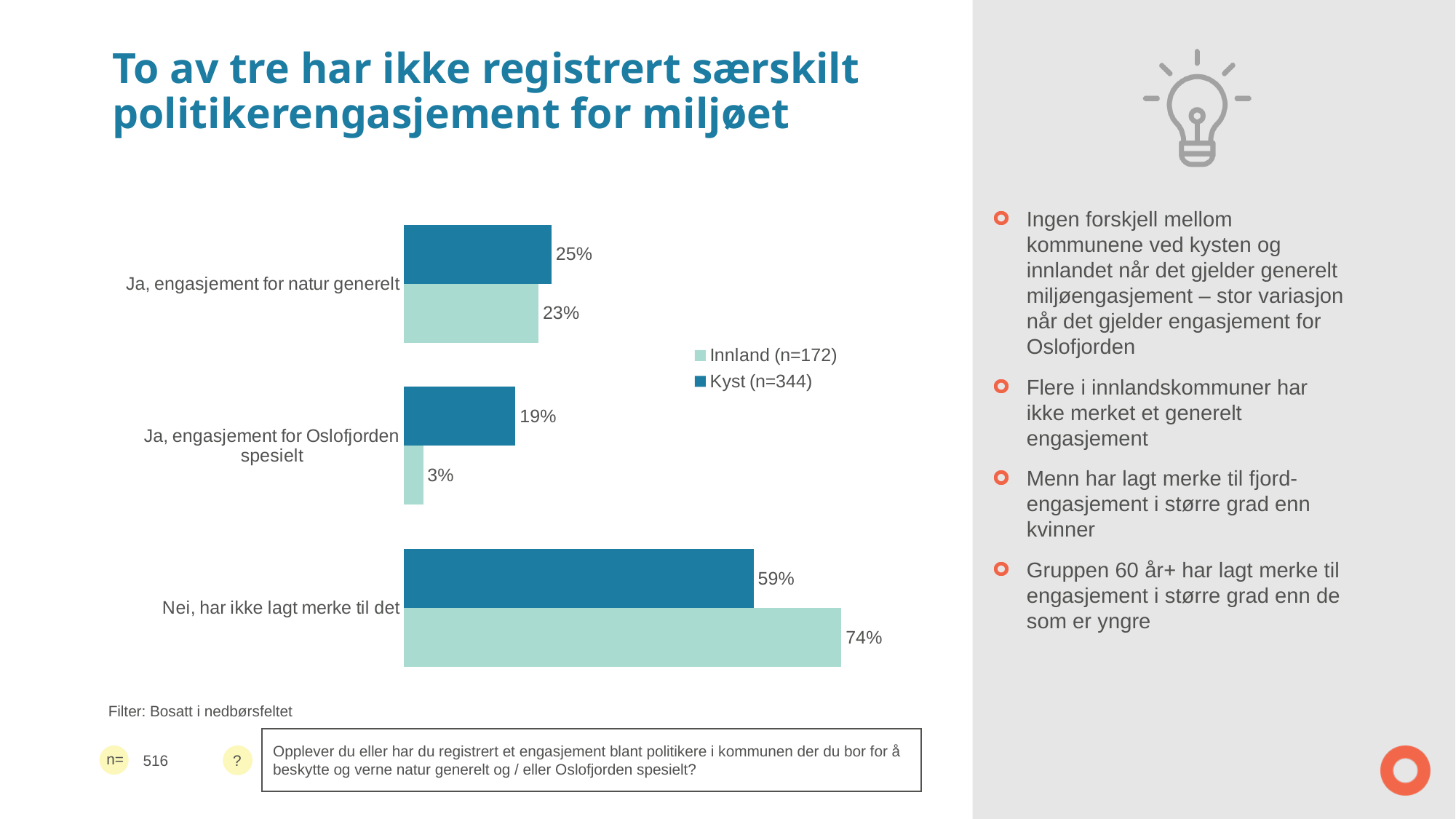
Which category has the highest value for the Innland (n=172) series? Nei, har ikke lagt merke til det What is the value for Kyst (n=344) for "Ja, engasjement for natur generelt"? 25% What is the value for Innland (n=172) for "Ja, engasjement for Oslofjorden spesielt"? 3% What is the value for Kyst (n=344) for "Nei, har ikke lagt merke til det"? 59% What kind of chart is shown on the slide? Bar chart What is the difference between the Innland (n=172) and Kyst (n=344) values for "Nei, har ikke lagt merke til det"? 15% What is the difference between the Kyst (n=344) and Innland (n=172) values for "Ja, engasjement for Oslofjorden spesielt"? 16% What is the value for Innland (n=172) for "Nei, har ikke lagt merke til det"? 74% For "Ja, engasjement for Oslofjorden spesielt", which series has the larger value, Innland (n=172) or Kyst (n=344)? Kyst (n=344) How many series does the legend list? 2 Which category has the lowest value for the Kyst (n=344) series? Ja, engasjement for Oslofjorden spesielt How many categories are shown on the chart? 3